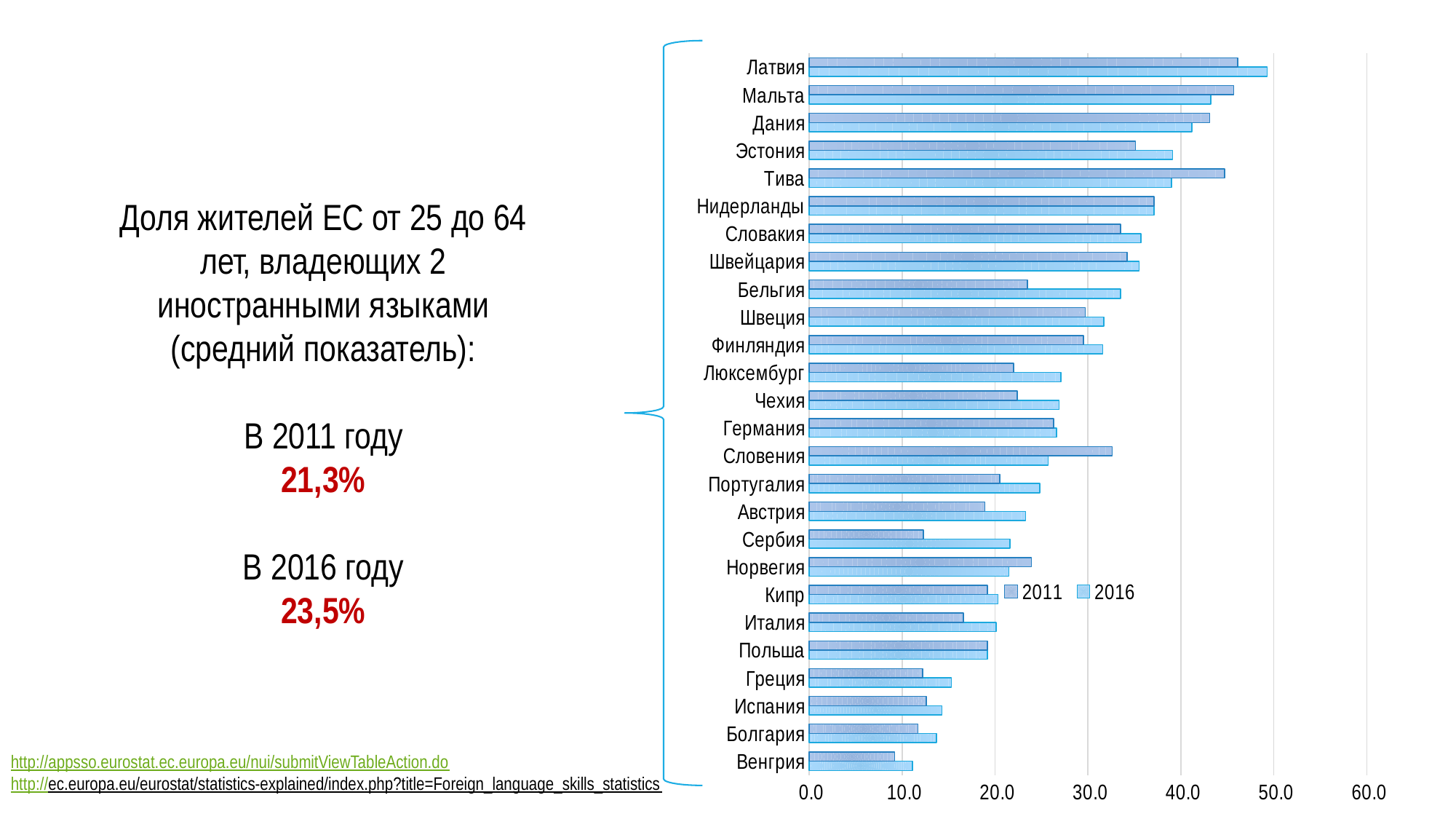
Is the 2016 value for Латвия greater or less than 40.0? greater Which country has the highest value for 2016? Латвия What kind of chart is shown on the slide? bar chart How many countries are shown on the chart? 26 Which country has the lowest value for 2016? Венгрия For Словения, which is larger: the 2011 value or the 2016 value? 2011 How many series does the chart's legend list? 2 Which country has the lowest value for 2011? Венгрия For Бельгия, which is larger: the 2011 value or the 2016 value? 2016 Which years are listed in the chart's legend? 2011 and 2016 Is the 2011 value for Венгрия greater or less than 10.0? less Is the 2011 value for Словения greater or less than 30.0? greater